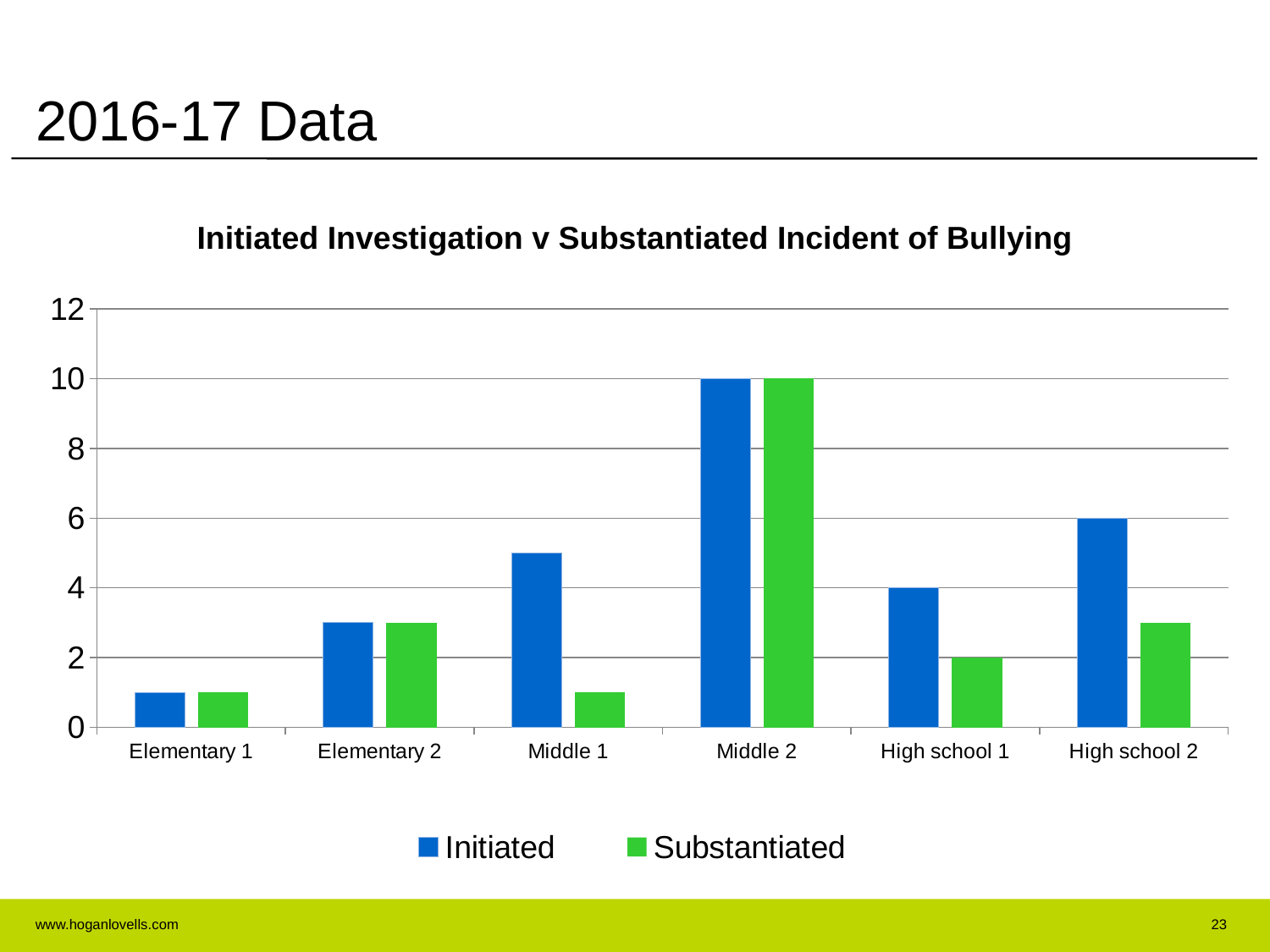
Is the Substantiated value for High school 2 greater or less than 4? less What is the title of the chart? Initiated Investigation v Substantiated Incident of Bullying How many school categories are shown on the x axis? 6 How many series does the legend list? 2 What type of chart is shown on the slide? bar chart Which school has the highest Initiated value? Middle 2 What is the Initiated value for Middle 2? 10 Is the Initiated value for Middle 1 greater or less than 4? greater What is the Initiated value for High school 2? 6 What is the Substantiated value for High school 1? 2 Which is larger for High school 1, the Initiated value or the Substantiated value? Initiated Which school has the lowest Initiated value? Elementary 1